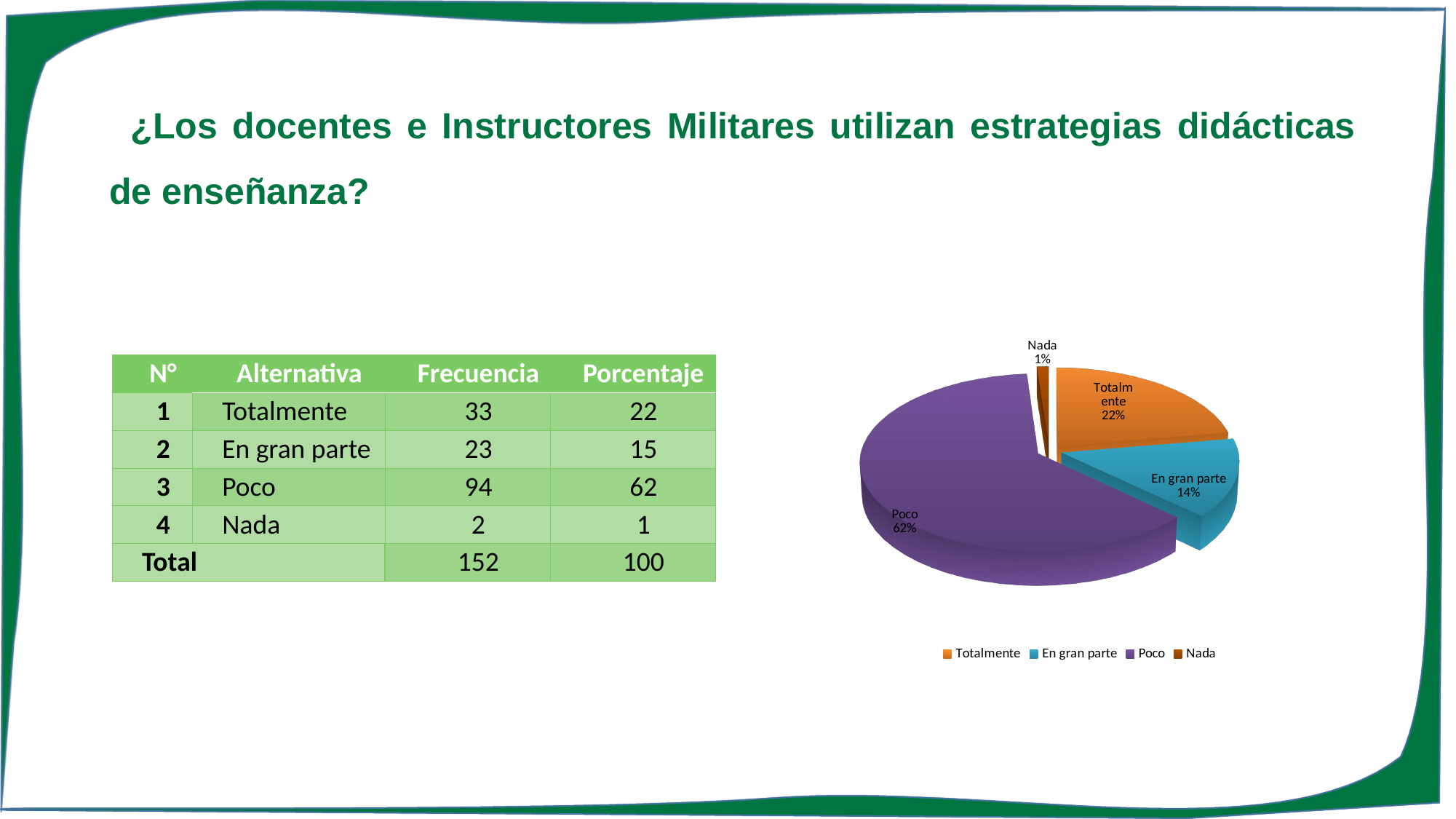
How many slices does the pie chart have? 4 In the pie chart, what percentage is shown for Nada? 1% Which category has the largest slice in the pie chart? Poco In the pie chart, what percentage is shown for En gran parte? 14% In the pie chart, which slice is larger, Totalmente or En gran parte? Totalmente What kind of chart is shown on the slide? pie chart In the pie chart, what is the difference in percentage points between Poco and Totalmente? 40 In the pie chart, what percentage is shown for Totalmente? 22% How many entries does the pie chart's legend list? 4 Which category has the smallest slice in the pie chart? Nada What colour is the Poco slice in the pie chart? purple In the pie chart, what percentage is shown for Poco? 62%